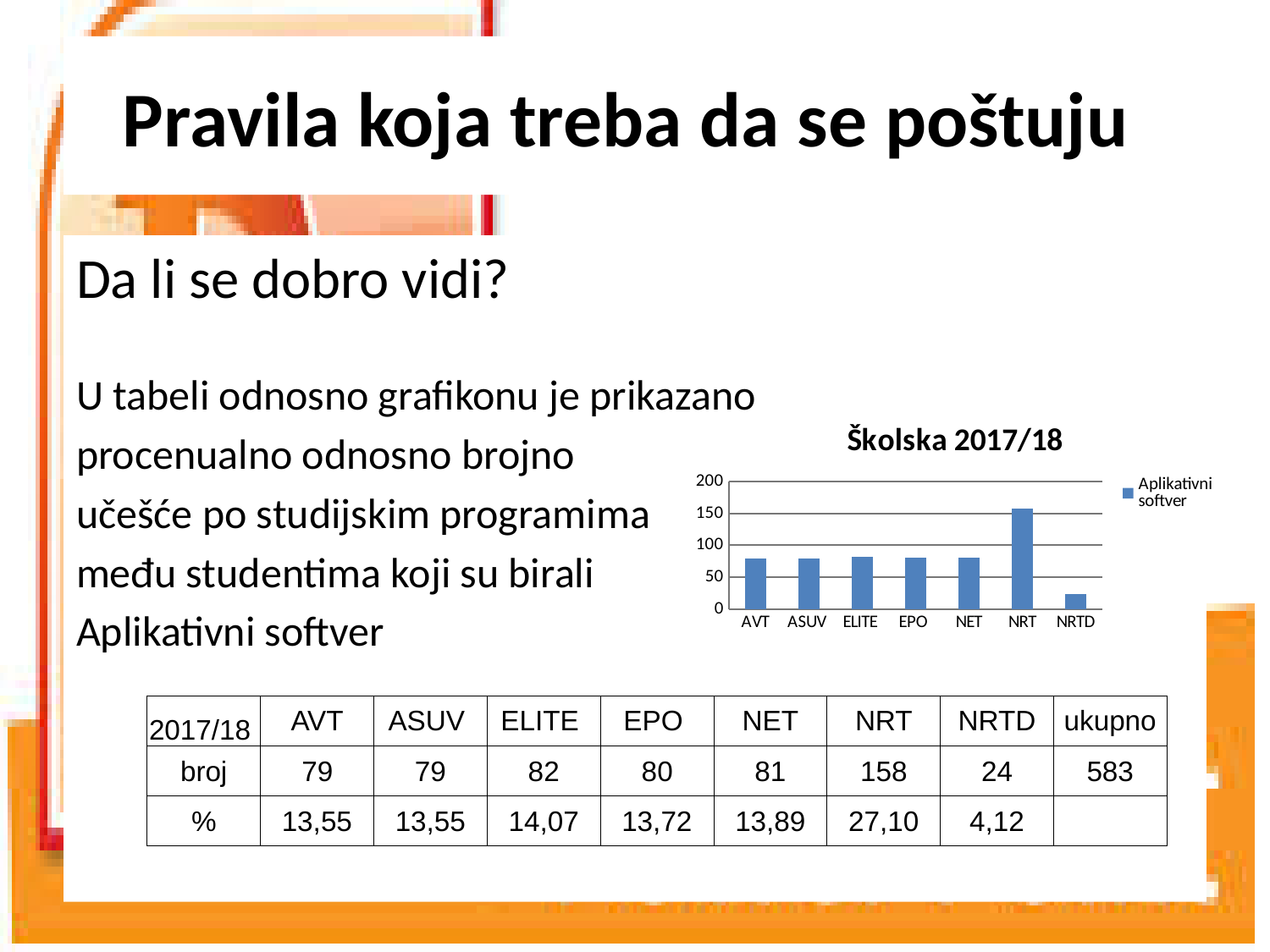
Is the value for NRTD in the chart greater or less than 50? less Which is larger in the chart, the value for NRT or the value for NET? NRT Which category has the highest bar in the chart? NRT Is the value for ELITE in the chart greater or less than 100? less Is the value for NRT in the chart greater or less than 150? greater Which category has the lowest bar in the chart? NRTD What is the title of the chart? Školska 2017/18 According to the table on the slide, what is the number (broj) for NRT? 158 What type of chart is shown on the slide? bar chart How many categories are shown on the x axis of the chart? 7 How many series does the chart legend list? 1 What is the name of the series in the chart legend? Aplikativni softver